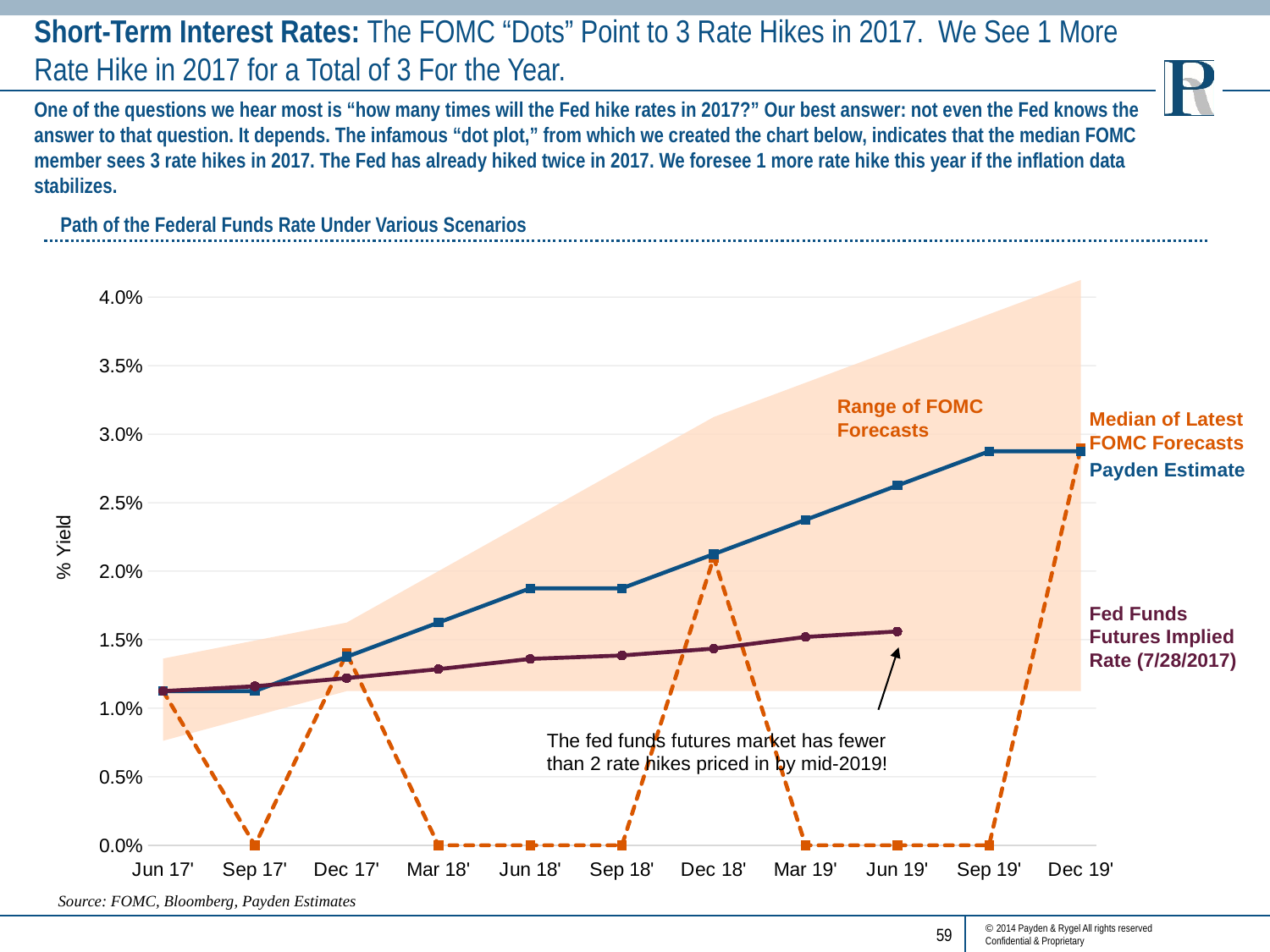
How many dates are shown along the x axis of the chart? 11 What is the title of the chart? Path of the Federal Funds Rate Under Various Scenarios Does the Median of Latest FOMC Forecasts line generally rise or fall from Jun 17' to Dec 19'? rise Is the Payden Estimate value at Dec 19' greater or less than 2.5%? greater What is the label on the y axis of the chart? % Yield What kind of chart is shown on the slide? line chart Is the Median of Latest FOMC Forecasts value at Dec 19' greater or less than 2.5%? greater At which date does the Fed Funds Futures Implied Rate line reach its highest value? Jun 19' Is the Fed Funds Futures Implied Rate value at Jun 19' greater or less than 2.0%? less At Dec 18', which is larger: the Median of Latest FOMC Forecasts or the Fed Funds Futures Implied Rate? Median of Latest FOMC Forecasts